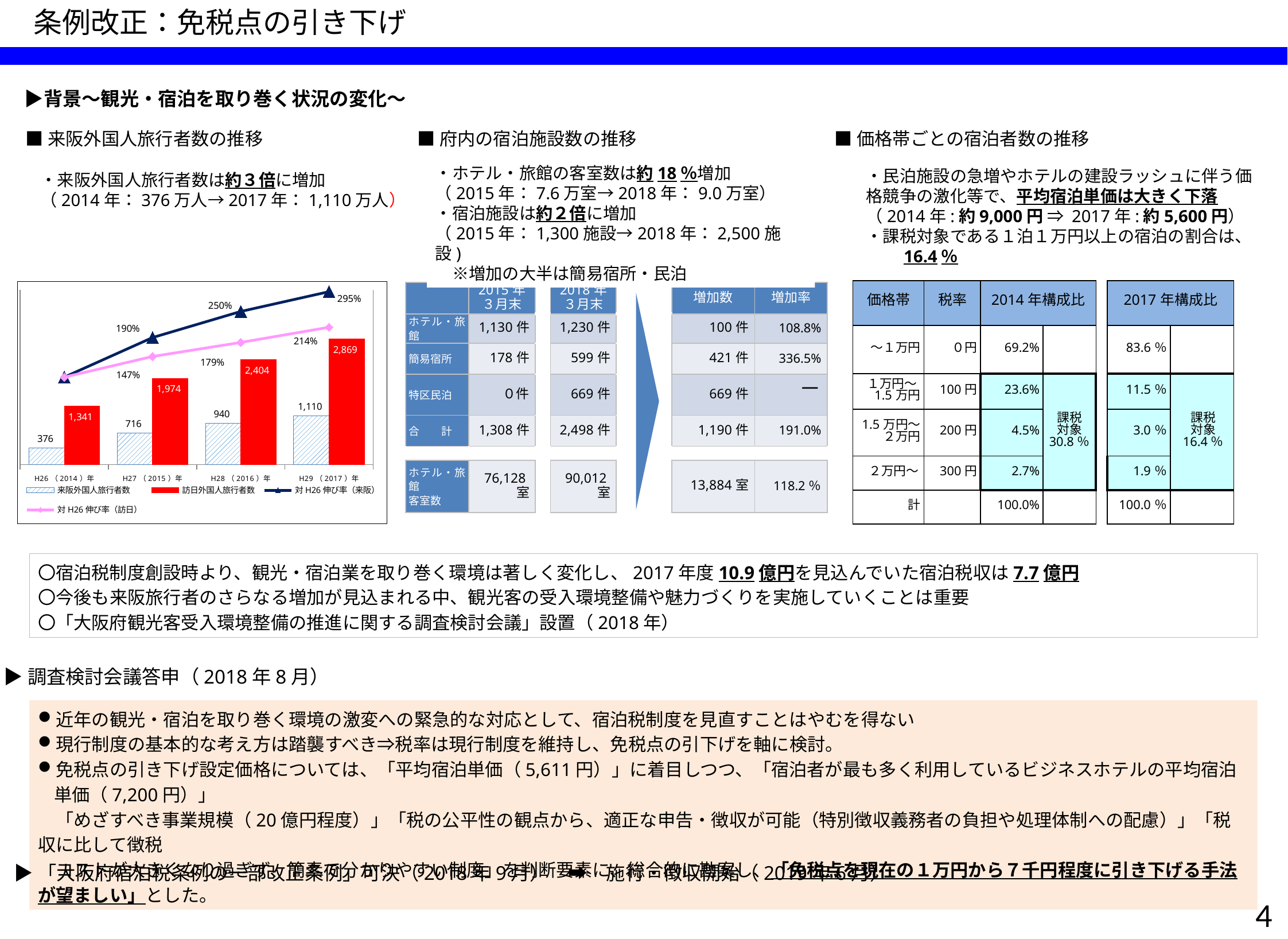
Which year has the highest value for 来阪外国人旅行者数? H29（2017）年 What is the value of 対H26伸び率（訪日） for H27（2015）年? 147% How many years are shown on the x axis of the chart? 4 What is the value of 訪日外国人旅行者数 for H29（2017）年? 2,869 Which year has the lowest value for 訪日外国人旅行者数? H26（2014）年 What is the value of 来阪外国人旅行者数 for H26（2014）年? 376 What is the difference between the 訪日外国人旅行者数 values for H29（2017）年 and H26（2014）年? 1,528 What kind of chart is shown under 来阪外国人旅行者数の推移? Combined bar and line chart How many series does the chart's legend list? 4 Does the 対H26伸び率（来阪） line rise or fall from H27（2015）年 to H29（2017）年? Rise Which is larger for H28（2016）年: 来阪外国人旅行者数 or 訪日外国人旅行者数? 訪日外国人旅行者数 What is the value of 対H26伸び率（来阪） for H28（2016）年? 250%